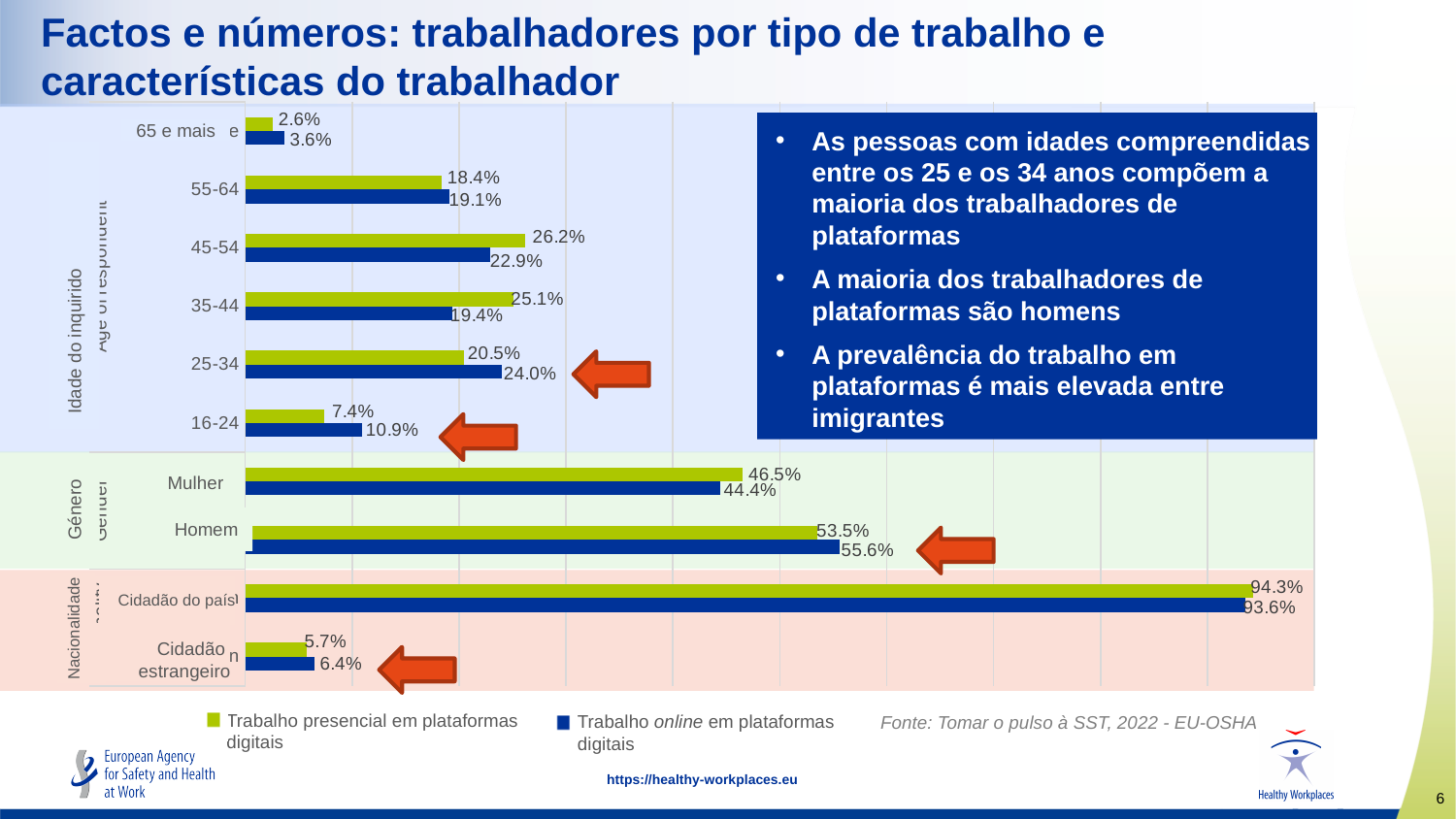
What kind of chart is shown on the slide? bar chart What is the difference between the 'Trabalho online em plataformas digitais' values for Homem and Mulher? 11.2% Among the age groups, which has the highest value for 'Trabalho online em plataformas digitais'? 25-34 How many series does the legend list? 2 What is the value for 'Trabalho presencial em plataformas digitais' for Cidadão estrangeiro? 5.7% Which is larger for the 35-44 age group: 'Trabalho presencial em plataformas digitais' or 'Trabalho online em plataformas digitais'? Trabalho presencial em plataformas digitais What is the value for 'Trabalho online em plataformas digitais' in the 25-34 age group? 24.0% What is the difference between the 'Trabalho presencial em plataformas digitais' and 'Trabalho online em plataformas digitais' values for the 16-24 age group? 3.5% What is the value for 'Trabalho presencial em plataformas digitais' in the 45-54 age group? 26.2% What is the value for 'Trabalho online em plataformas digitais' for Homem? 55.6% Among the age groups, which has the lowest value for 'Trabalho presencial em plataformas digitais'? 65 e mais How many age-group categories are shown in the 'Idade do inquirido' section of the chart? 6